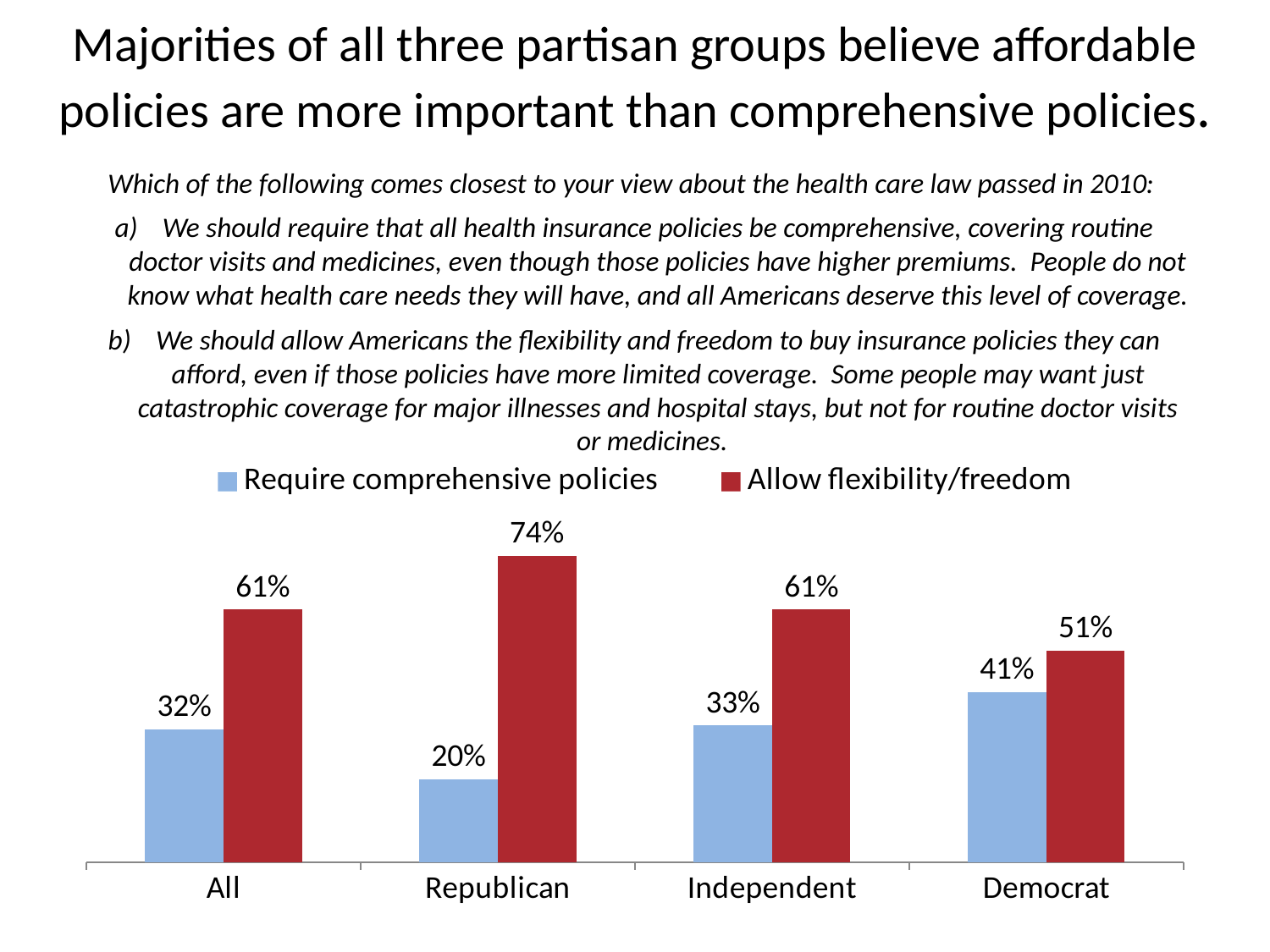
Which group has the lowest value for 'Require comprehensive policies'? Republican How many series does the legend list? 2 What percentage of Republicans say we should allow flexibility/freedom? 74% What is the difference between 'Allow flexibility/freedom' and 'Require comprehensive policies' for the All group? 29% What kind of chart is shown on the slide? Bar chart What percentage of Democrats say we should require comprehensive policies? 41% Which is larger: 'Require comprehensive policies' for Democrats or for Independents? Democrats How many partisan groups (categories) are shown on the x axis? 4 Which colour represents 'Allow flexibility/freedom' in the chart? Red What is the value for 'Require comprehensive policies' among Independents? 33% What is the difference between the 'Allow flexibility/freedom' values for Republicans and Democrats? 23% Which group has the highest value for 'Allow flexibility/freedom'? Republican